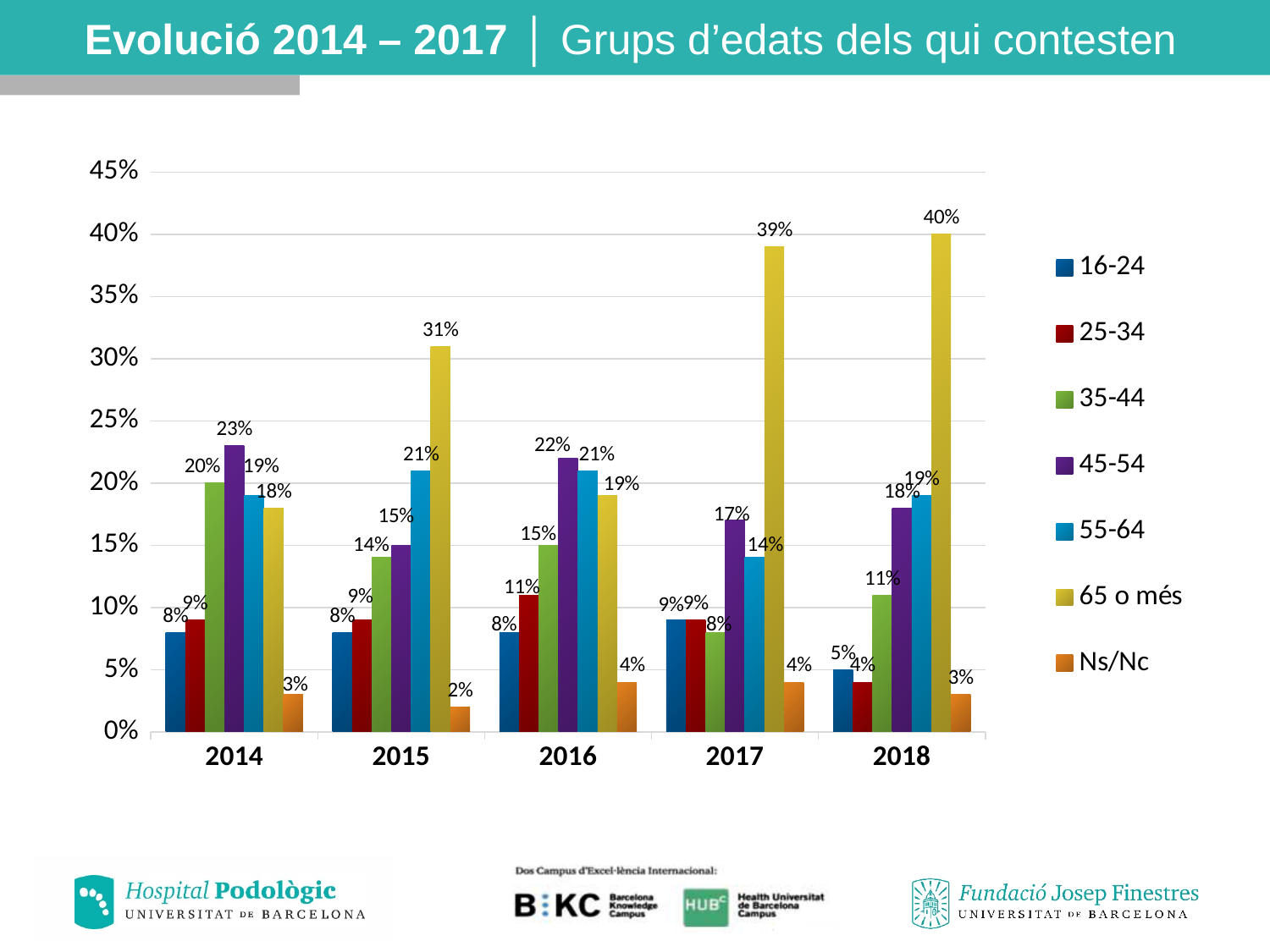
How many years are shown on the x axis? 5 What is the value for the 65 o més series in 2018? 40% How many series does the legend list? 7 What kind of chart is shown on the slide? Bar chart What is the difference between the 65 o més values in 2017 and 2015? 8% What is the value for the 45-54 series in 2014? 23% What is the value for the 55-64 series in 2015? 21% In which year is the 16-24 series lowest? 2018 Which is larger in 2016: the 45-54 value or the 55-64 value? 45-54 In which year is the 65 o més series highest? 2018 Does the 65 o més series rise or fall from 2016 to 2018? Rise What is the value for the Ns/Nc series in 2016? 4%